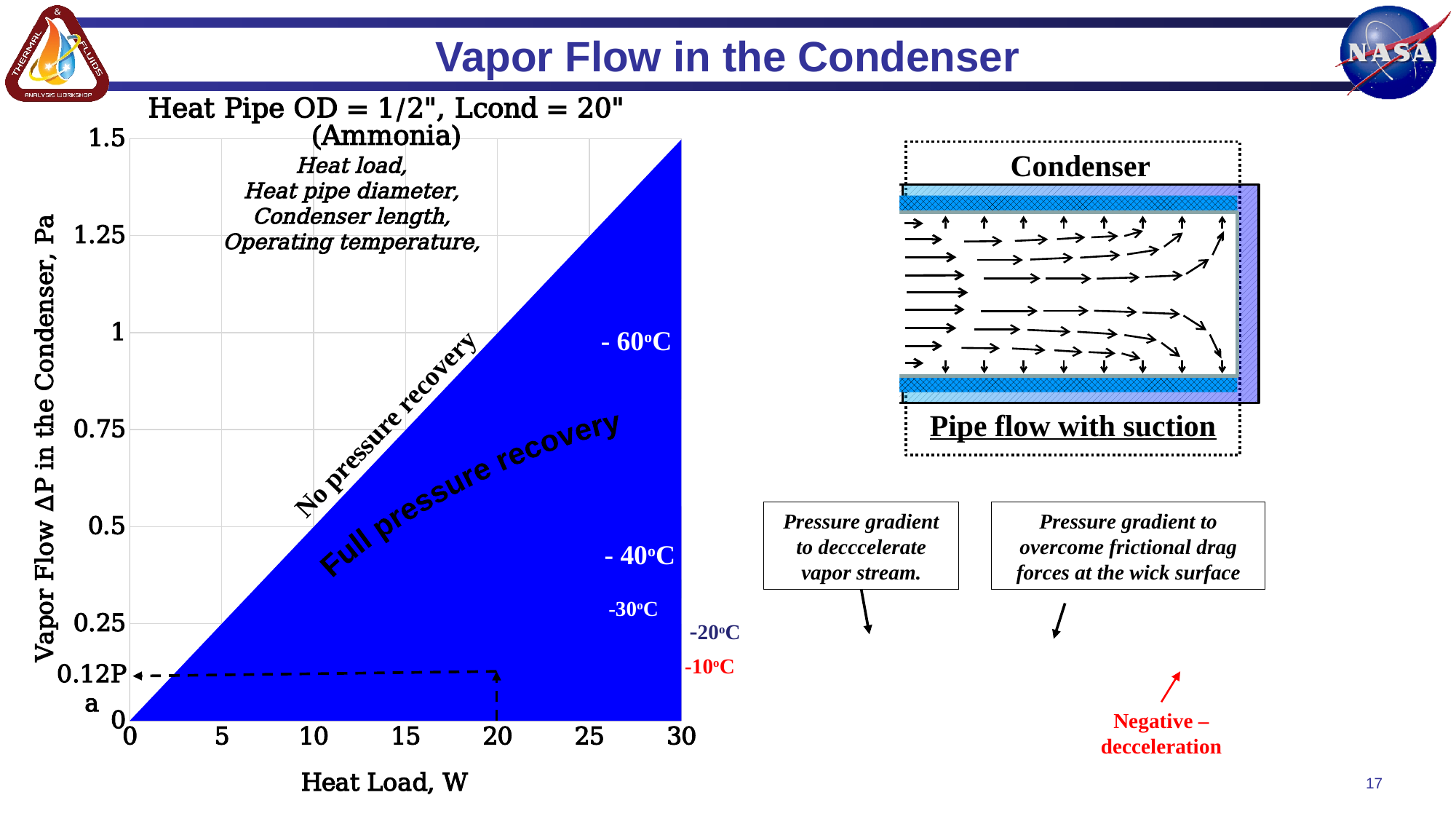
What kind of chart is shown on the left of the slide? area chart According to the dashed lines on the chart, what is the vapor flow ΔP at a heat load of 20 W? 0.12Pa What is the maximum value shown on the y axis of the chart? 1.5 Which is larger, the vapor flow ΔP at 30 W or at 15 W? 30 W Does the vapor flow ΔP rise or fall as heat load increases along the x axis? rise Is the vapor flow ΔP at a heat load of 5 W greater or less than 0.5 Pa? less How many tick labels are shown on the x axis of the chart? 7 Is the vapor flow ΔP at a heat load of 10 W greater or less than 0.75 Pa? less What is the maximum heat load shown on the x axis of the chart? 30 What is the label of the x axis of the chart? Heat Load, W Is the vapor flow ΔP at a heat load of 25 W greater or less than 1 Pa? greater What is the title of the chart on the left? Heat Pipe OD = 1/2", Lcond = 20" (Ammonia)